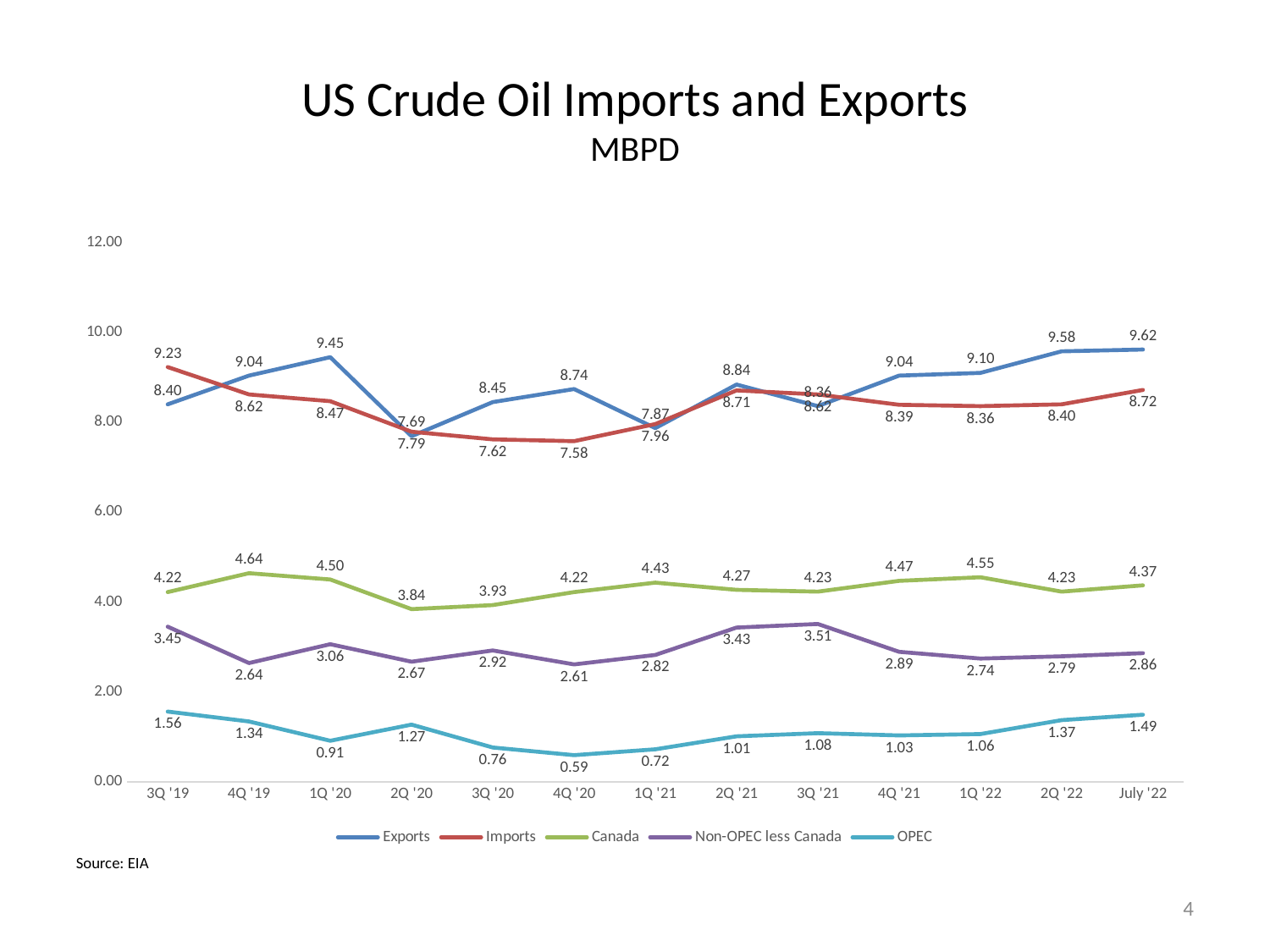
In 2Q '21, which is larger: Canada or Non-OPEC less Canada? Canada In which period is the Exports value highest? July '22 In which period is the OPEC value lowest? 4Q '20 Is the OPEC value for 4Q '20 greater or less than 1.00? less What is the Canada value for 4Q '19? 4.64 How many series does the legend list? 5 What is the difference between Exports and Imports in July '22? 0.90 What is the Imports value for 4Q '20? 7.58 What is the Exports value for July '22? 9.62 What kind of chart is shown on the slide? line chart In which period is the Non-OPEC less Canada value highest? 3Q '21 How many time periods are shown on the x axis? 13